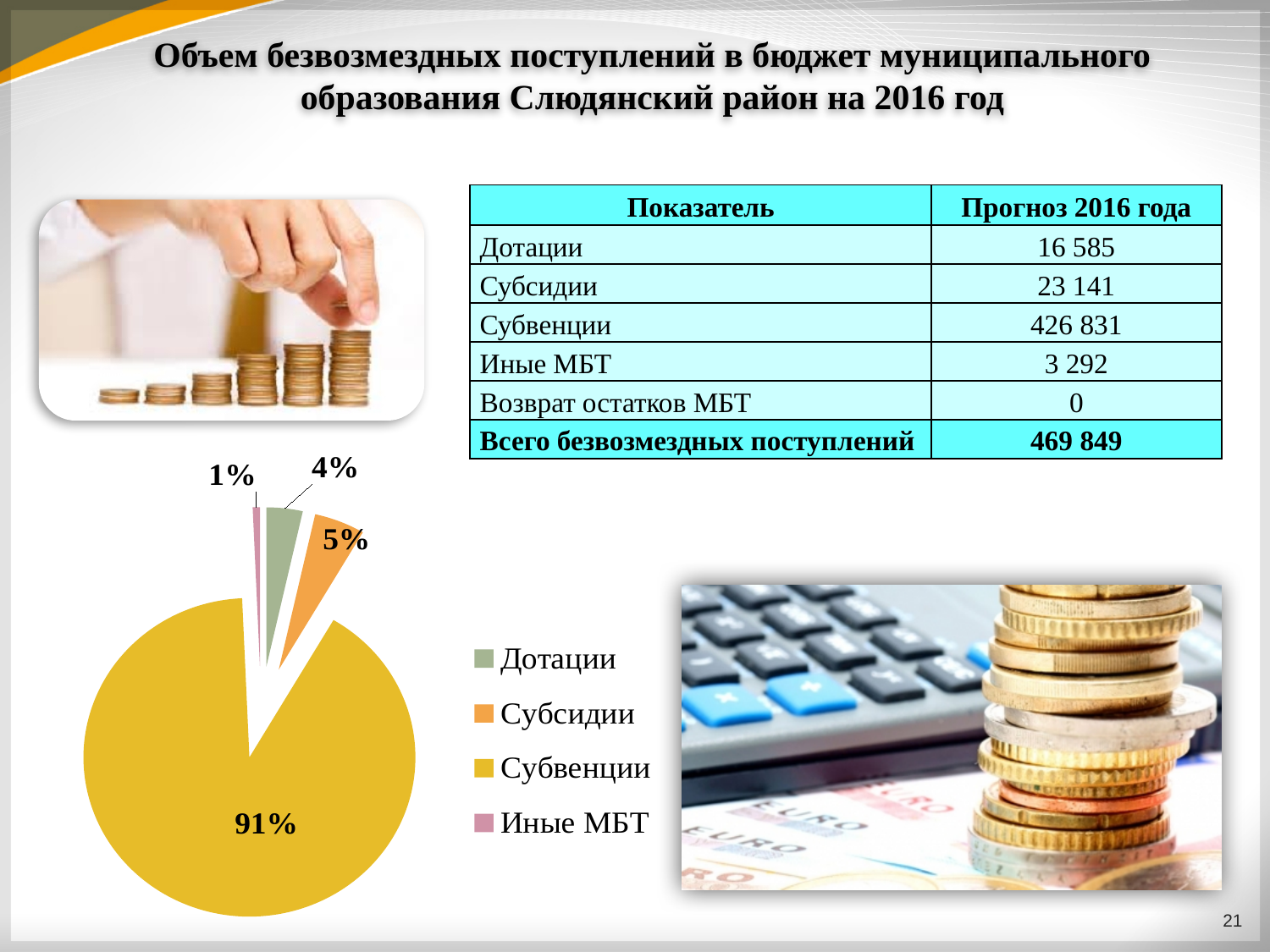
What share of the pie chart does Дотации represent? 4% How many entries does the pie chart legend list? 4 What colour is the Субвенции slice in the pie chart? Yellow Which category has the smallest slice in the pie chart? Иные МБТ What share of the pie chart does Субвенции represent? 91% What share of the pie chart does Иные МБТ represent? 1% Which slice is larger in the pie chart, Субсидии or Дотации? Субсидии By how many percentage points does the Субвенции slice exceed the Субсидии slice? 86 What type of chart is shown on the slide? Pie chart How many slices does the pie chart have? 4 Which category has the largest slice in the pie chart? Субвенции